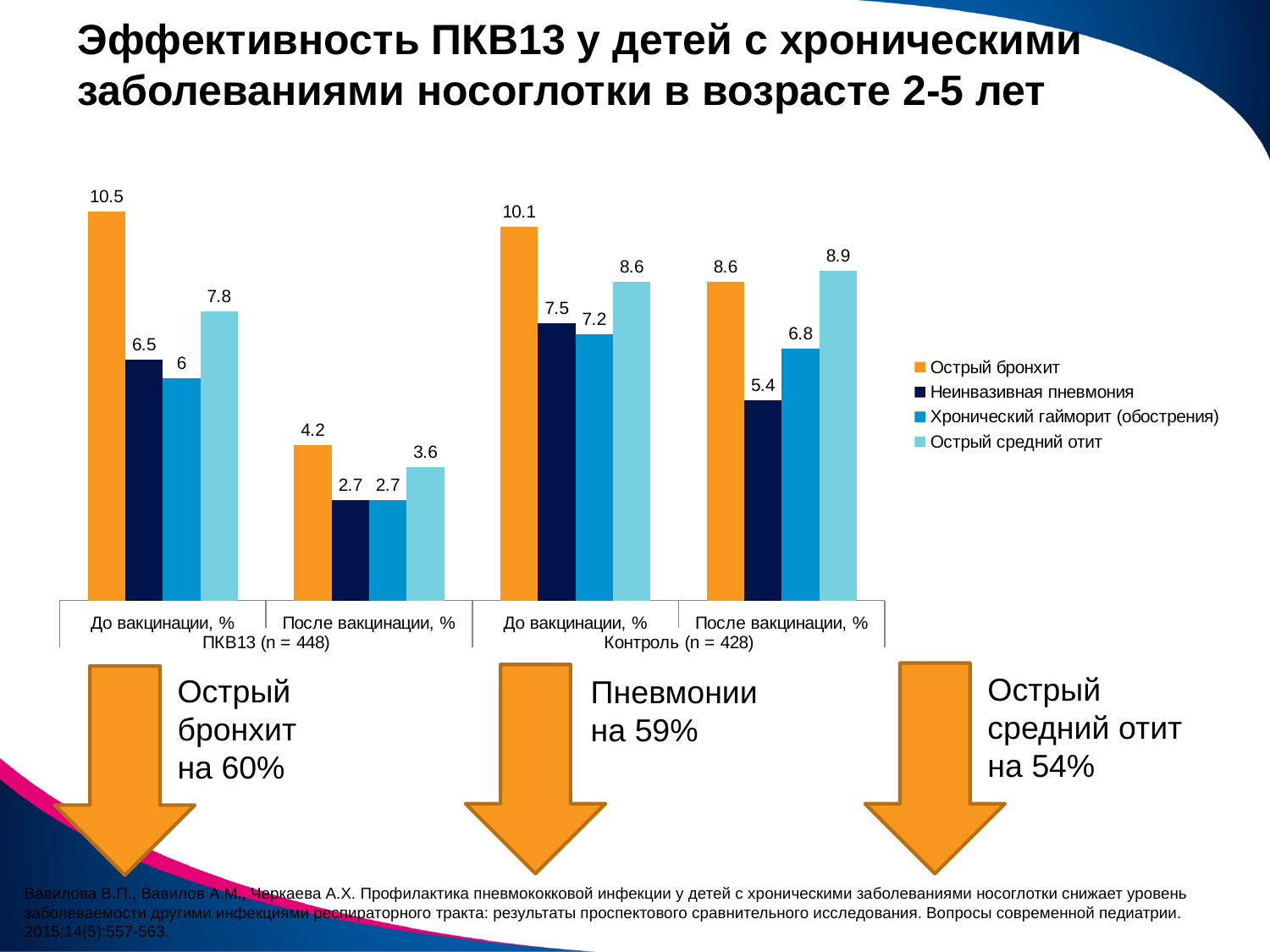
What is the sample size (n) shown for the ПКВ13 group? n = 448 What is the value for Острый бронхит in the ПКВ13 group before vaccination (До вакцинации)? 10.5 Which series has the highest value in the ПКВ13 group before vaccination (До вакцинации)? Острый бронхит Which series has the lowest value in the Контроль group after vaccination (После вакцинации)? Неинвазивная пневмония What is the value for Хронический гайморит (обострения) in the Контроль group before vaccination (До вакцинации)? 7.2 What type of chart is shown on the slide? bar chart What is the value for Острый средний отит in the ПКВ13 group after vaccination (После вакцинации)? 3.6 Which is larger: Острый средний отит in the Контроль group after vaccination or Острый средний отит in the Контроль group before vaccination? Контроль after vaccination (8.9) What is the difference between the Острый бронхит values before and after vaccination in the ПКВ13 group? 6.3 How many series does the legend list? 4 How many category groups are shown along the x axis? 4 What is the value for Неинвазивная пневмония in the Контроль group after vaccination (После вакцинации)? 5.4